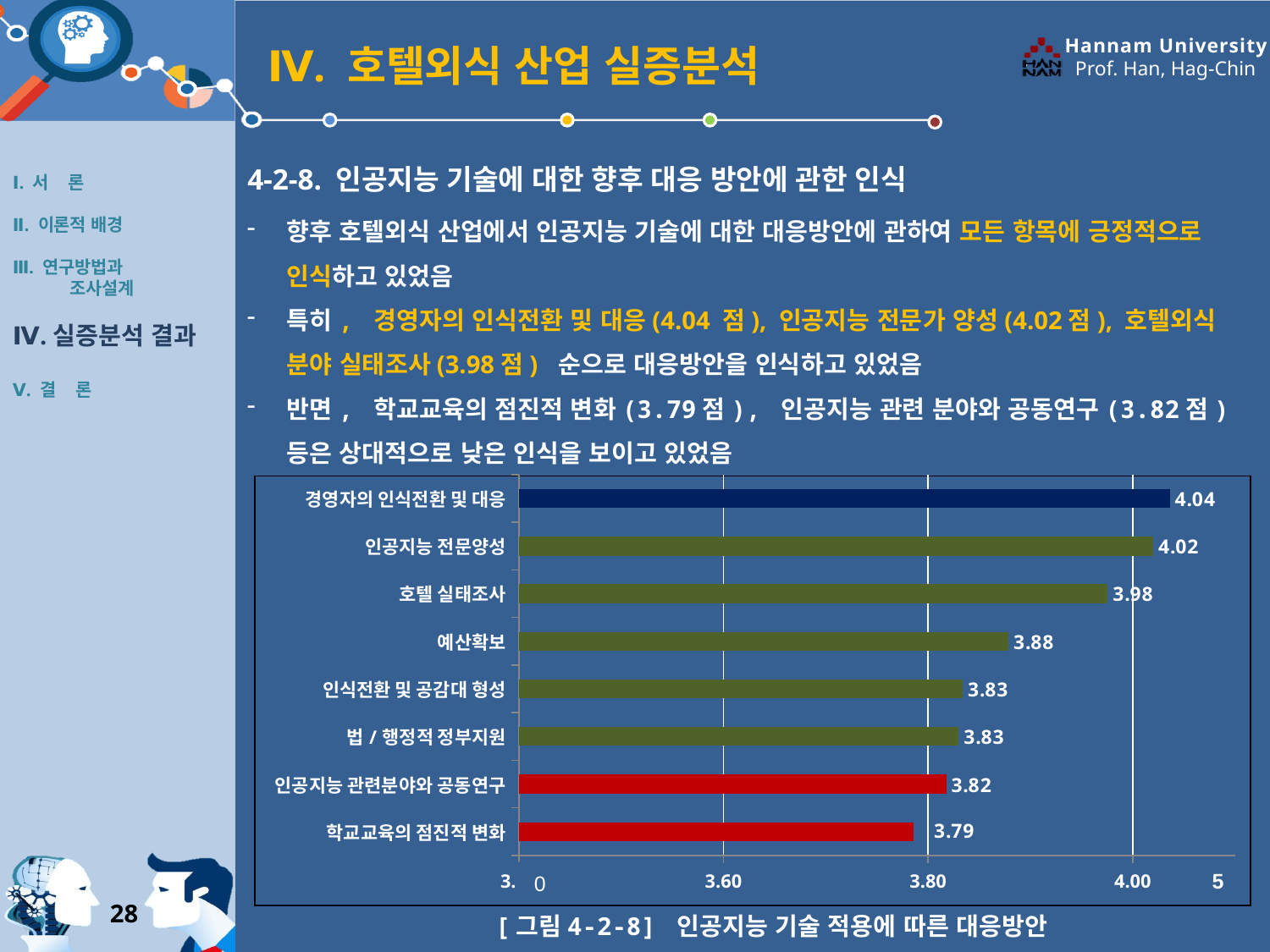
What is the value for 경영자의 인식전환 및 대응? 4.04 How many categories are shown in the chart? 8 What is the value for 학교교육의 점진적 변화? 3.79 Is the value for 인공지능 관련분야와 공동연구 greater or less than 4.00? less What is the caption of the chart shown below the bars? [그림 4-2-8] 인공지능 기술 적용에 따른 대응방안 What is the difference between the values for 인공지능 전문양성 and 호텔 실태조사? 0.04 What is the difference between the values for 경영자의 인식전환 및 대응 and 학교교육의 점진적 변화? 0.25 Which category has the lowest value? 학교교육의 점진적 변화 Which is larger, the value for 호텔 실태조사 or the value for 예산확보? 호텔 실태조사 Which category has the highest value? 경영자의 인식전환 및 대응 What kind of chart is shown on the slide? bar chart What is the value for 예산확보? 3.88